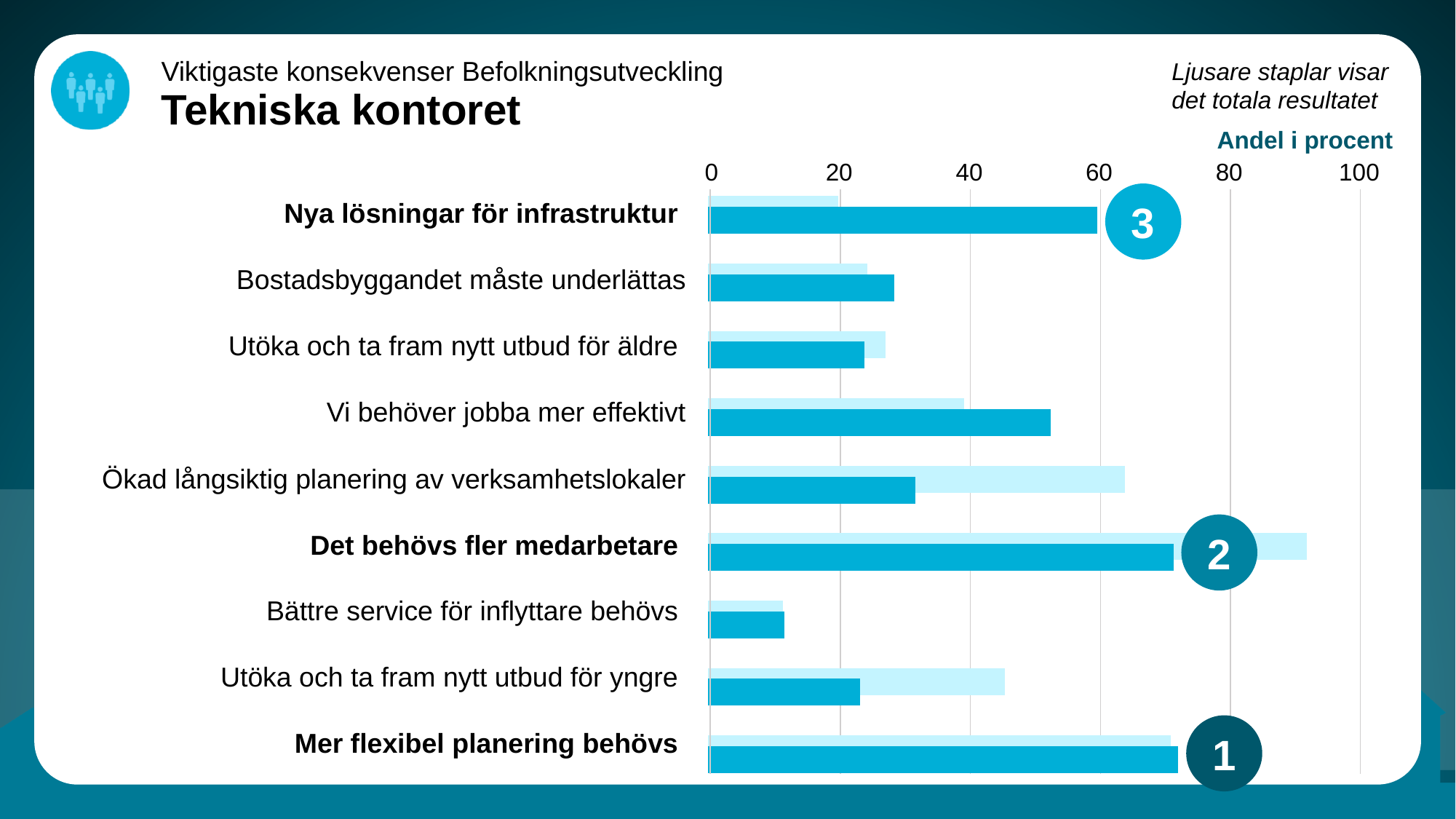
Which category has the highest value for the lighter bars? Det behövs fler medarbetare Which category has the lowest value for the darker bars? Bättre service för inflyttare behövs For Nya lösningar för infrastruktur, which bar is larger, the darker bar or the lighter bar? the darker bar Is the darker bar value for Vi behöver jobba mer effektivt greater or less than 40? greater According to the note on the slide, what do the lighter bars show? det totala resultatet Is the lighter bar value for Det behövs fler medarbetare greater or less than 80? greater Is the darker bar value for Bättre service för inflyttare behövs greater or less than 20? less How many categories are plotted on the chart? 9 What is the title of the chart's axis label shown above the scale? Andel i procent What kind of chart is shown on the slide? bar chart For Ökad långsiktig planering av verksamhetslokaler, which bar is larger, the darker bar or the lighter bar? the lighter bar